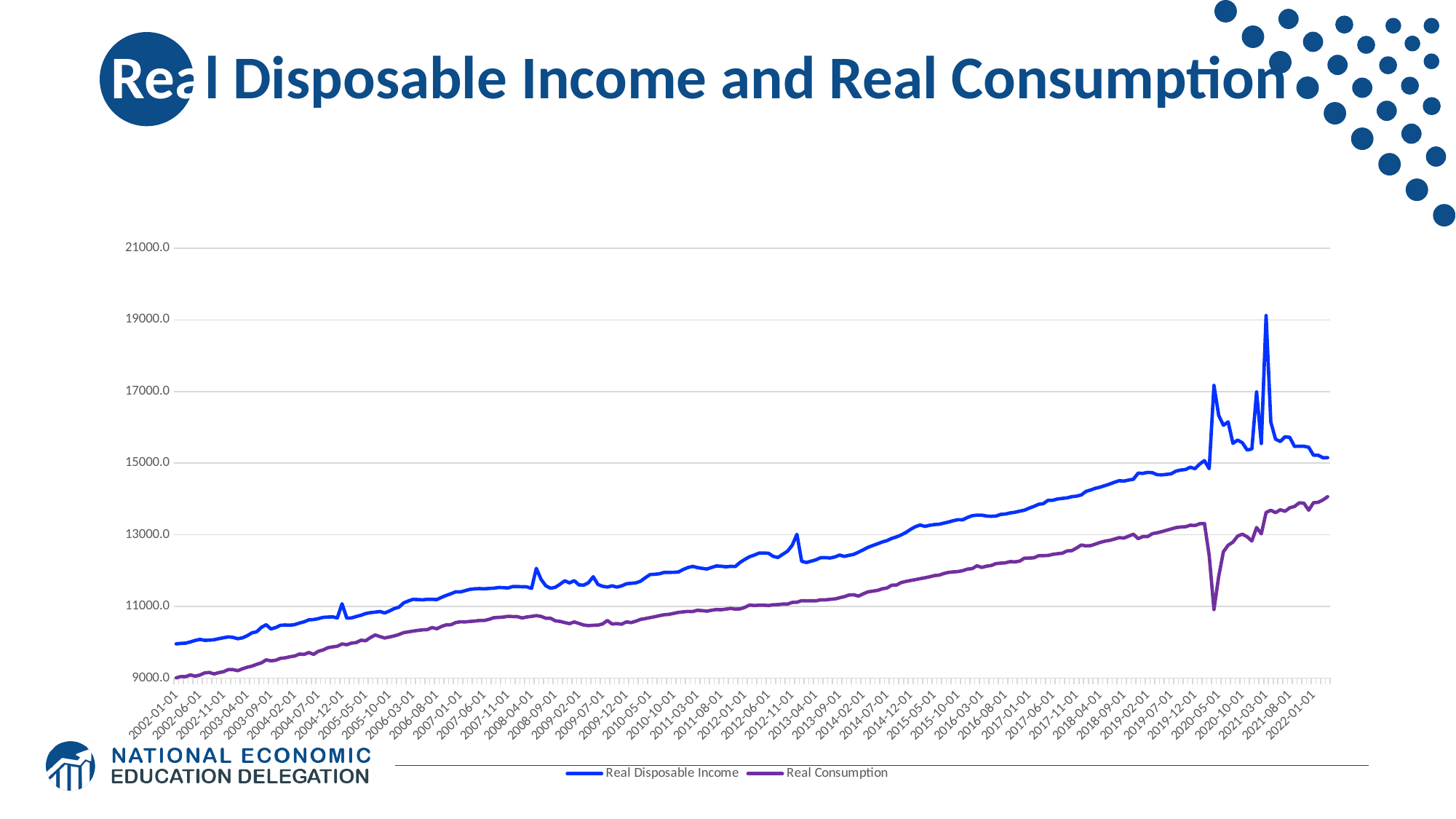
What are the two series named in the legend? Real Disposable Income and Real Consumption Is the highest peak of Real Disposable Income greater or less than 17000.0? greater What colour is the Real Disposable Income line? blue Is the value for Real Consumption at 2022-01-01 greater or less than 13000.0? greater Is the value for Real Disposable Income at 2012-01-01 greater or less than 13000.0? less How many series does the legend list? 2 Which series reaches the highest value anywhere on the chart? Real Disposable Income Which series is higher at 2022-01-01, Real Disposable Income or Real Consumption? Real Disposable Income What kind of chart is shown on the slide? line chart Does Real Consumption generally rise or fall from 2002-01-01 to 2022-01-01? rise